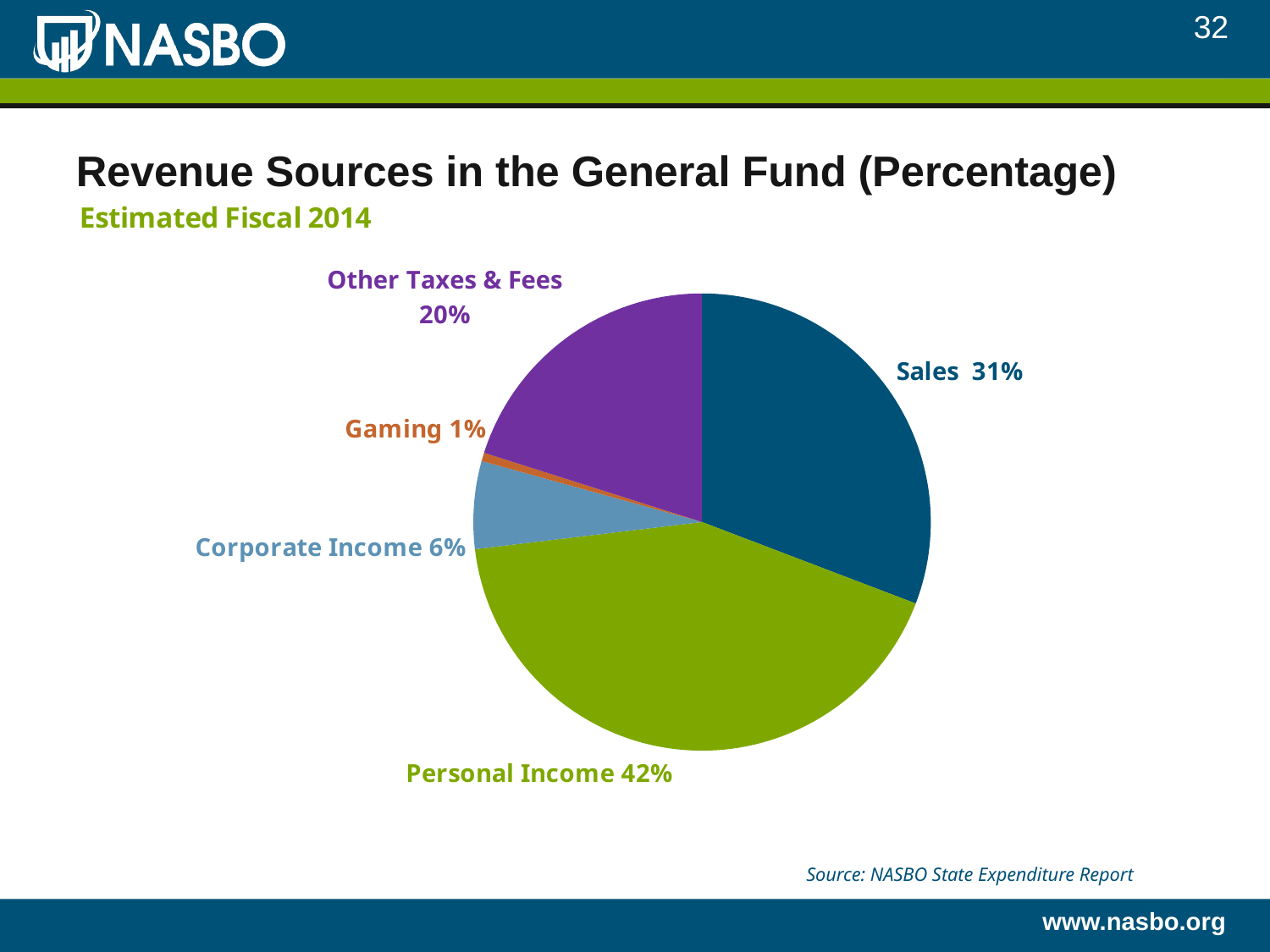
What percentage of the General Fund revenue comes from Sales? 31% What type of chart is used on this slide? Pie chart What percentage of the General Fund revenue comes from Personal Income? 42% What percentage of the General Fund revenue comes from Corporate Income? 6% What is the difference in percentage points between Personal Income and Sales? 11 Which revenue source has the smallest share of the General Fund? Gaming How many revenue sources are shown in the pie chart? 5 What percentage of the General Fund revenue comes from Other Taxes & Fees? 20% Which revenue source has the largest share of the General Fund? Personal Income What percentage of the General Fund revenue comes from Gaming? 1% Which is larger, the share for Other Taxes & Fees or the share for Corporate Income? Other Taxes & Fees Which fiscal year does the chart show estimates for? Estimated Fiscal 2014